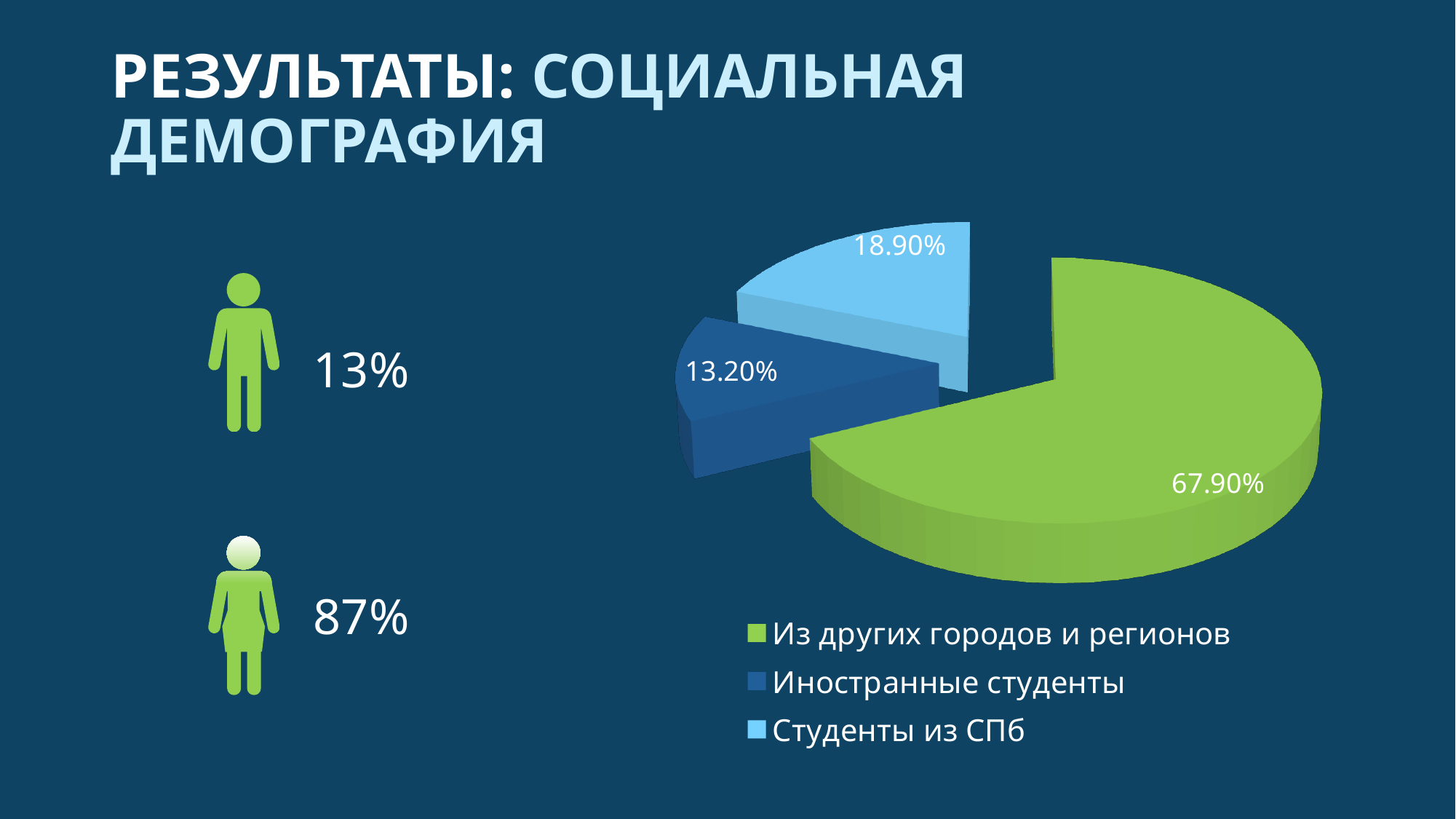
Which category has the largest slice in the pie chart? Из других городов и регионов How many entries does the pie chart legend list? 3 What value is shown for "Иностранные студенты" in the pie chart? 13.20% What share of the pie chart is labelled "Из других городов и регионов"? 67.90% Which category has the smallest slice in the pie chart? Иностранные студенты What is the difference between the "Из других городов и регионов" slice and the "Студенты из СПб" slice? 49.00% What colour is the "Из других городов и регионов" slice in the pie chart? Green What is the difference between the "Студенты из СПб" slice and the "Иностранные студенты" slice? 5.70% What type of chart is shown on the slide? Pie chart What value is shown for "Студенты из СПб" in the pie chart? 18.90% Which is larger in the pie chart: "Студенты из СПб" or "Иностранные студенты"? Студенты из СПб How many slices does the pie chart have? 3